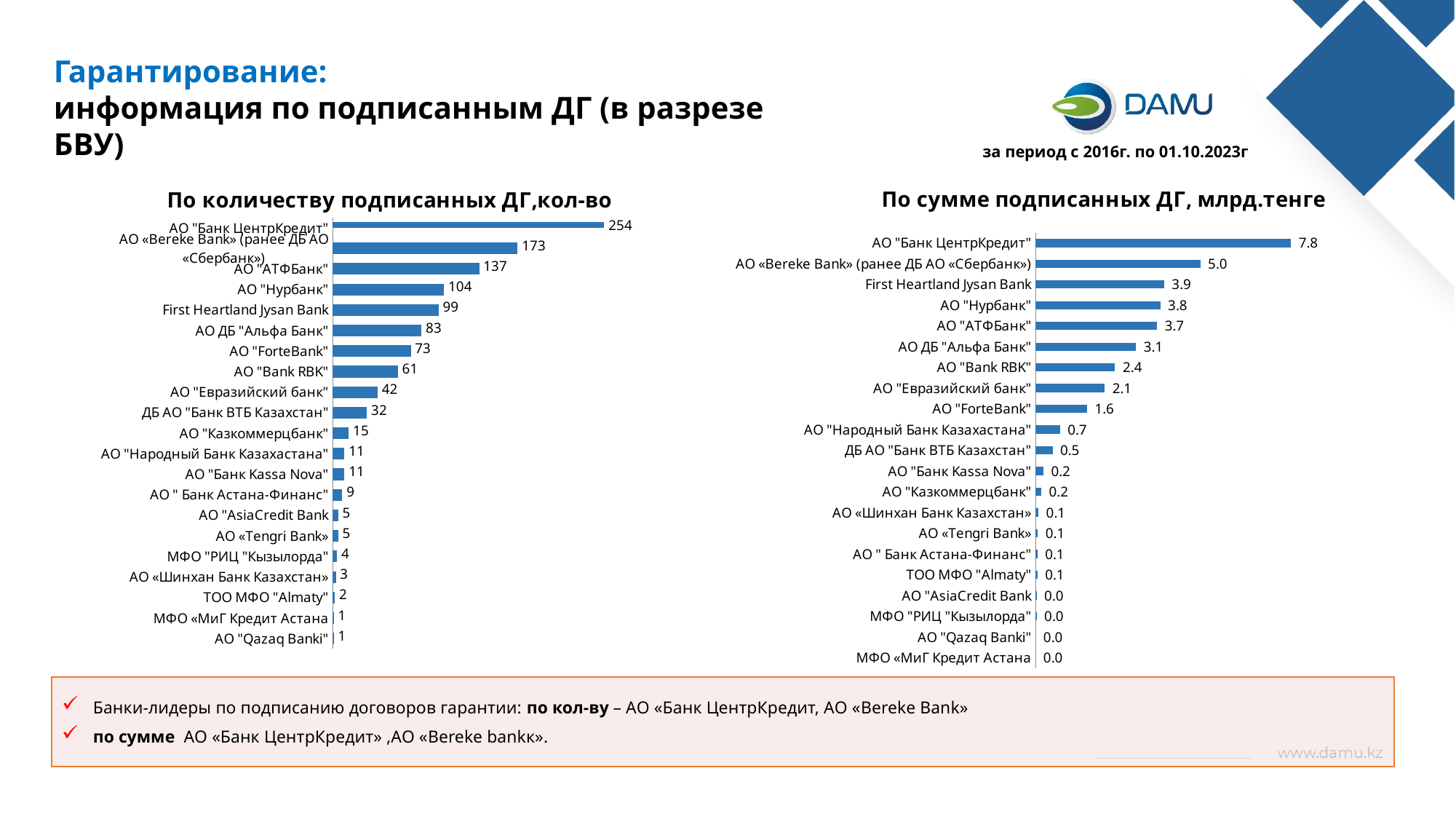
In the chart "По количеству подписанных ДГ,кол-во", which bank has the highest value? АО "Банк ЦентрКредит" What period is stated on the slide for the data in the charts? за период с 2016г. по 01.10.2023г In the chart "По сумме подписанных ДГ, млрд.тенге", which is larger: АО "Bank RBK" or АО "ForteBank"? АО "Bank RBK" In the chart "По сумме подписанных ДГ, млрд.тенге", which bank has the highest value? АО "Банк ЦентрКредит" In the chart "По количеству подписанных ДГ,кол-во", which is larger: АО "Нурбанк" or First Heartland Jysan Bank? АО "Нурбанк" In the chart "По количеству подписанных ДГ,кол-во", what is the value for АО "Банк ЦентрКредит"? 254 In the chart "По количеству подписанных ДГ,кол-во", what is the value for АО "ForteBank"? 73 In the chart "По количеству подписанных ДГ,кол-во", what is the difference between АО "Банк ЦентрКредит" and АО «Bereke Bank» (ранее ДБ АО «Сбербанк»)? 81 In the chart "По сумме подписанных ДГ, млрд.тенге", what is the difference between АО "Банк ЦентрКредит" and АО «Bereke Bank» (ранее ДБ АО «Сбербанк»)? 2.8 What type of chart is "По сумме подписанных ДГ, млрд.тенге"? Bar chart In the chart "По сумме подписанных ДГ, млрд.тенге", what is the value for First Heartland Jysan Bank? 3.9 How many banks are listed in the chart "По количеству подписанных ДГ,кол-во"? 21